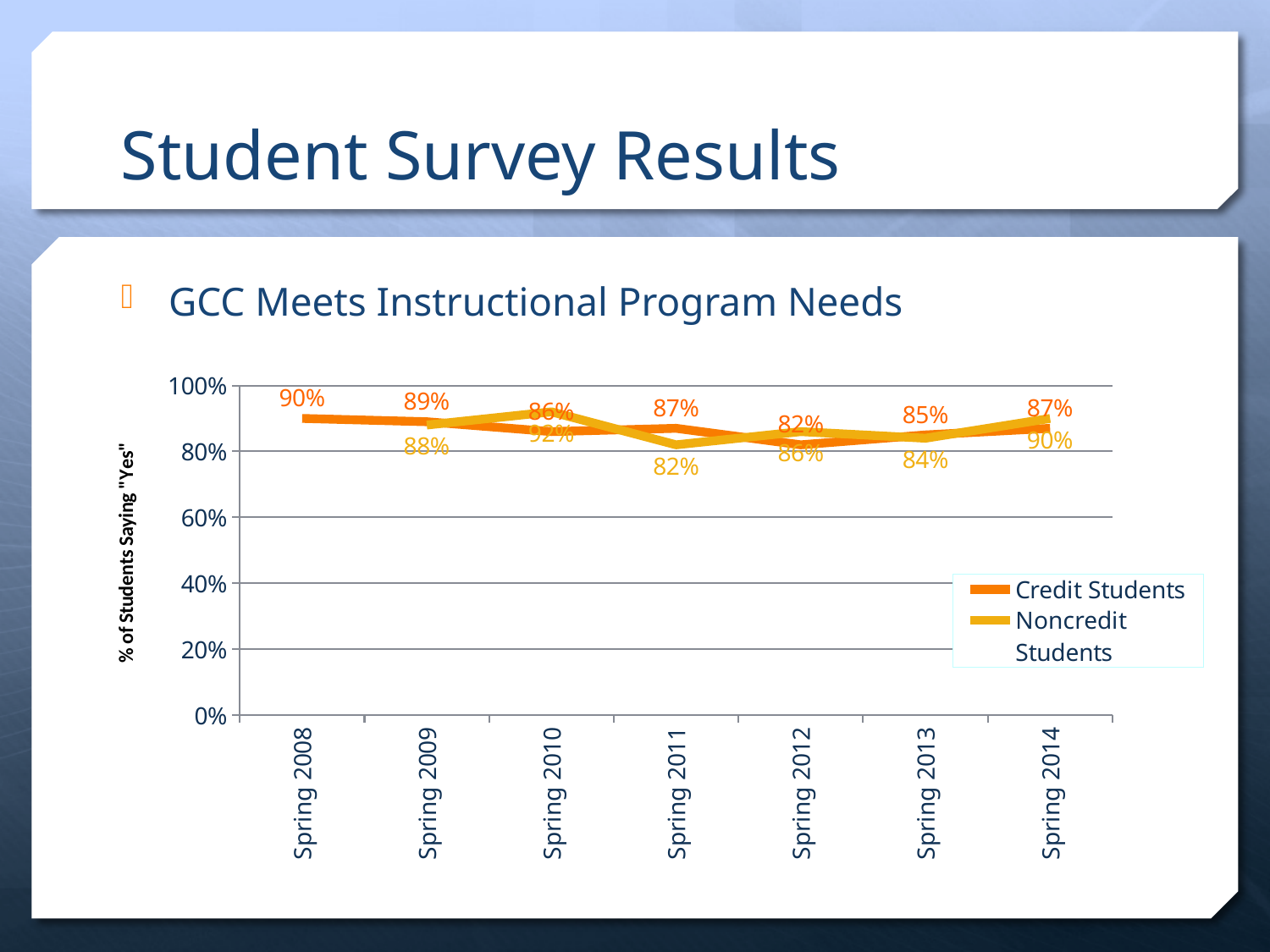
What is the value for Noncredit Students in Spring 2013? 84% In which survey period is the Credit Students value lowest? Spring 2012 What is the value for Credit Students in Spring 2012? 82% What kind of chart is shown on the slide? line chart What percentage of Credit Students said "Yes" in Spring 2008? 90% What is the value for Noncredit Students in Spring 2010? 92% How many survey periods are shown on the x axis? 7 How many series does the legend list? 2 In Spring 2010, which series has the higher value, Credit Students or Noncredit Students? Noncredit Students In which survey period is the Credit Students value highest? Spring 2008 In Spring 2011, how many percentage points higher is the Credit Students value than the Noncredit Students value? 5 percentage points What is the value for Noncredit Students in Spring 2014? 90%